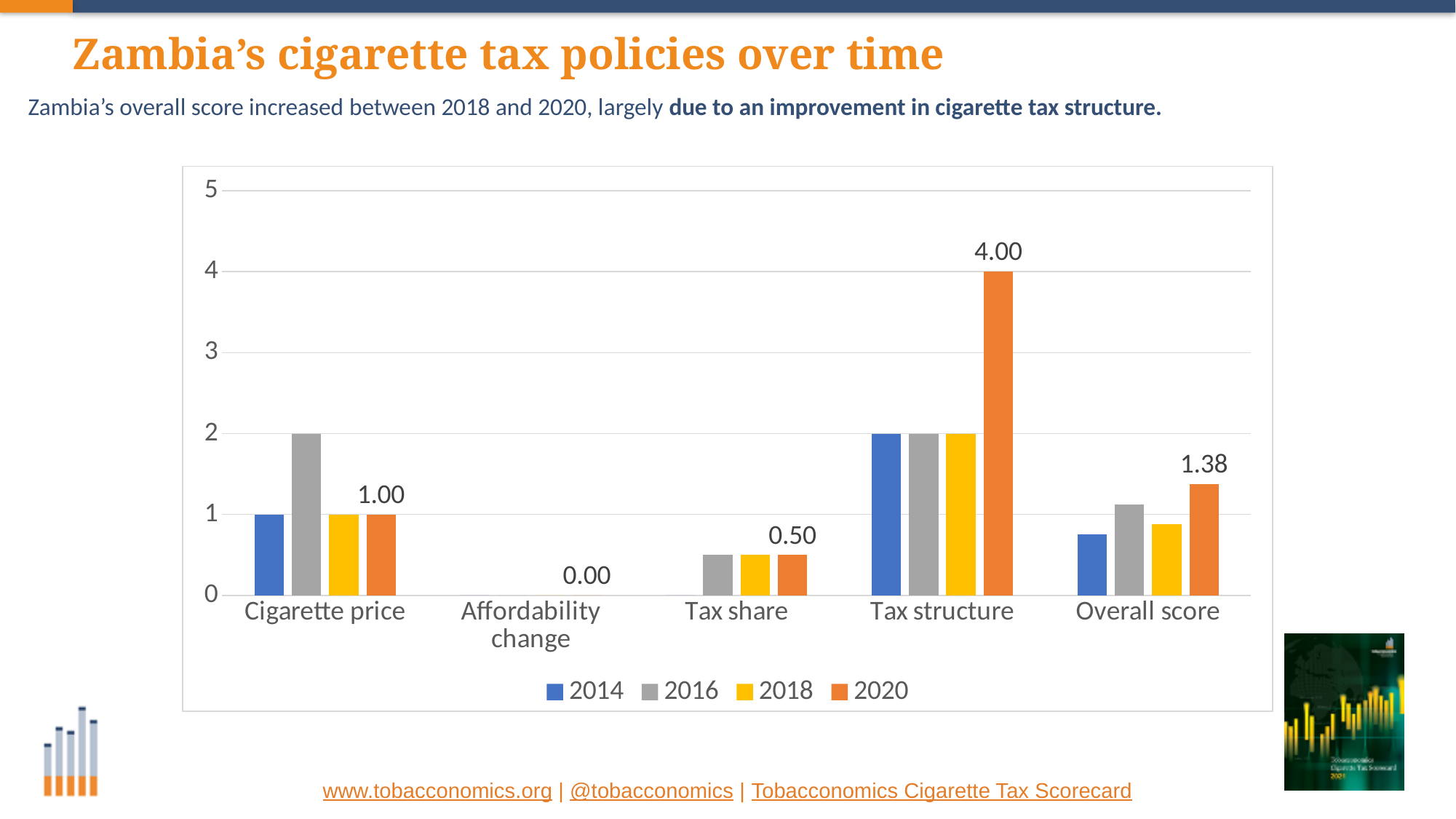
How many categories are shown on the x axis? 5 What is the 2016 value for Cigarette price? 2 What is the 2020 value for Tax structure? 4.00 How many series does the legend list? 4 Which is larger in 2020: Cigarette price or Tax share? Cigarette price What is the 2020 value for Affordability change? 0.00 What is the 2020 value for Tax share? 0.50 What kind of chart is shown on the slide? Bar chart What is the 2020 value for Overall score? 1.38 Which category has the highest 2020 value? Tax structure Is the 2016 value for Overall score greater or less than 1? greater What is the difference between the 2020 values for Tax structure and Overall score? 2.62